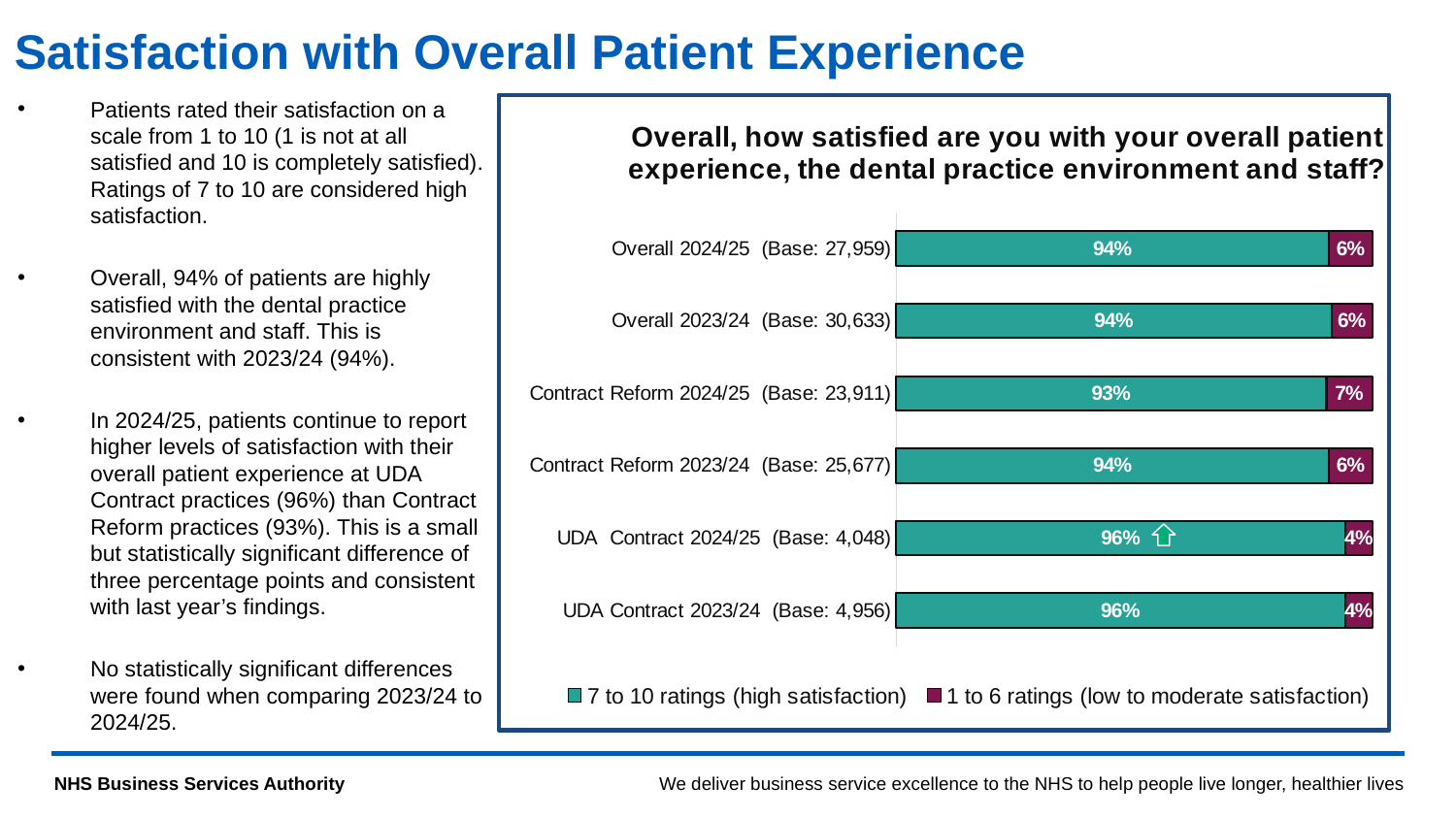
How many series does the legend list? 2 Which category has the lowest percentage of 7 to 10 ratings (high satisfaction)? Contract Reform 2024/25 How many categories are shown on the chart? 6 What is the difference in percentage points between the 7 to 10 ratings for UDA Contract 2024/25 and Contract Reform 2024/25? 3 percentage points Which is larger: the 7 to 10 ratings share for UDA Contract 2024/25 or for Contract Reform 2024/25? UDA Contract 2024/25 Which category has the highest percentage of 1 to 6 ratings (low to moderate satisfaction)? Contract Reform 2024/25 What kind of chart is shown on the slide? Stacked bar chart What percentage of patients gave 1 to 6 ratings (low to moderate satisfaction) for Contract Reform 2024/25? 7% What percentage of patients gave 1 to 6 ratings (low to moderate satisfaction) for UDA Contract 2023/24? 4% What percentage of patients gave 7 to 10 ratings (high satisfaction) for Overall 2024/25? 94% What is the base (number of respondents) shown for Overall 2024/25? 27,959 What percentage of patients gave 7 to 10 ratings (high satisfaction) for UDA Contract 2024/25? 96%